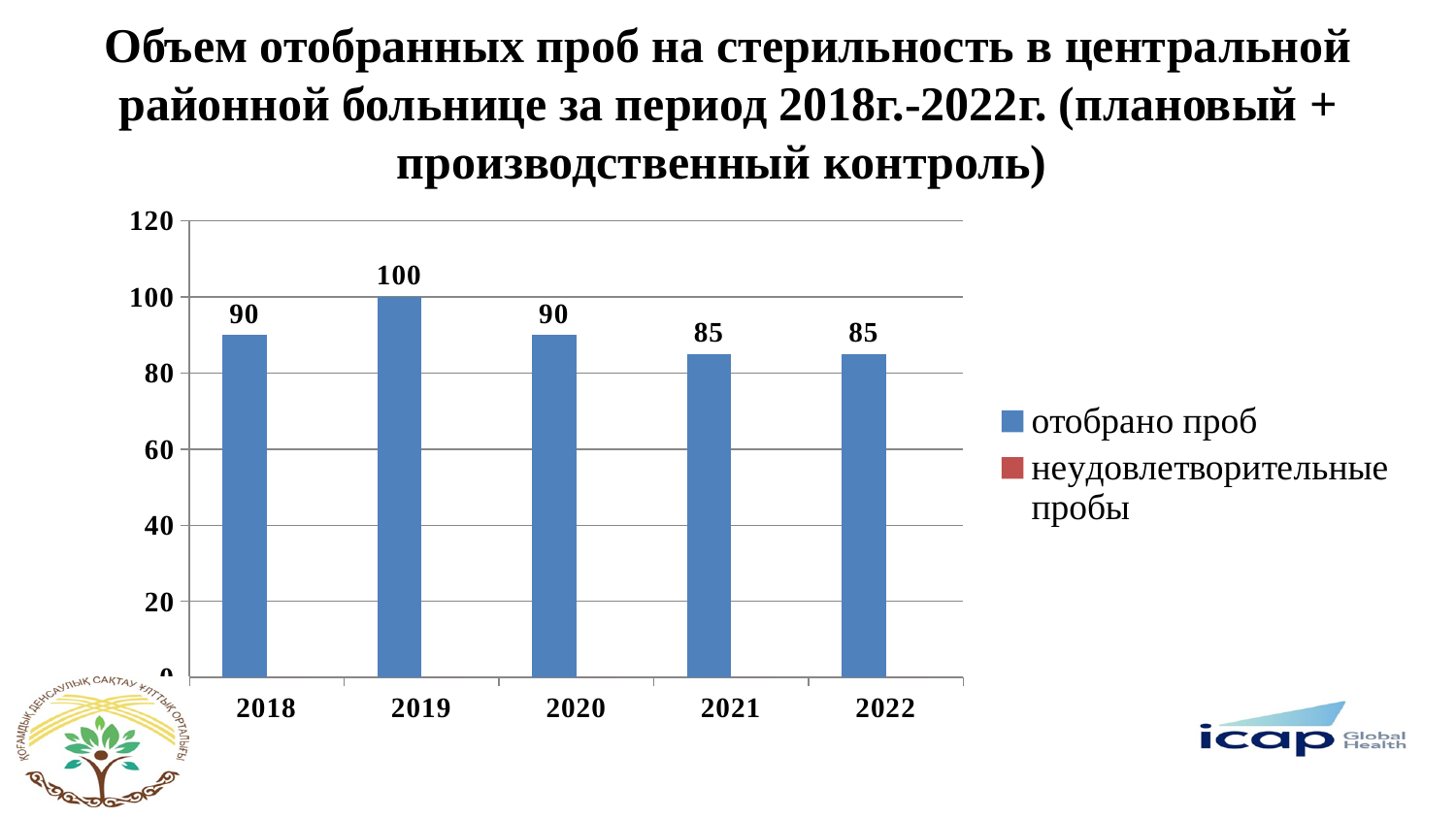
How many series does the legend list? 2 What kind of chart is shown on the slide? bar chart What is the difference between the values for 2019 and 2020? 10 Which year has the highest value? 2019 Which is larger, the value for 2019 or the value for 2021? 2019 What is the value for 2021? 85 Do the values rise or fall from 2019 to 2022? fall What is the value for 2018? 90 What is the value for 2019? 100 Is the value for 2022 greater or less than 100? less How many years are shown on the x axis? 5 What is the difference between the values for 2018 and 2022? 5